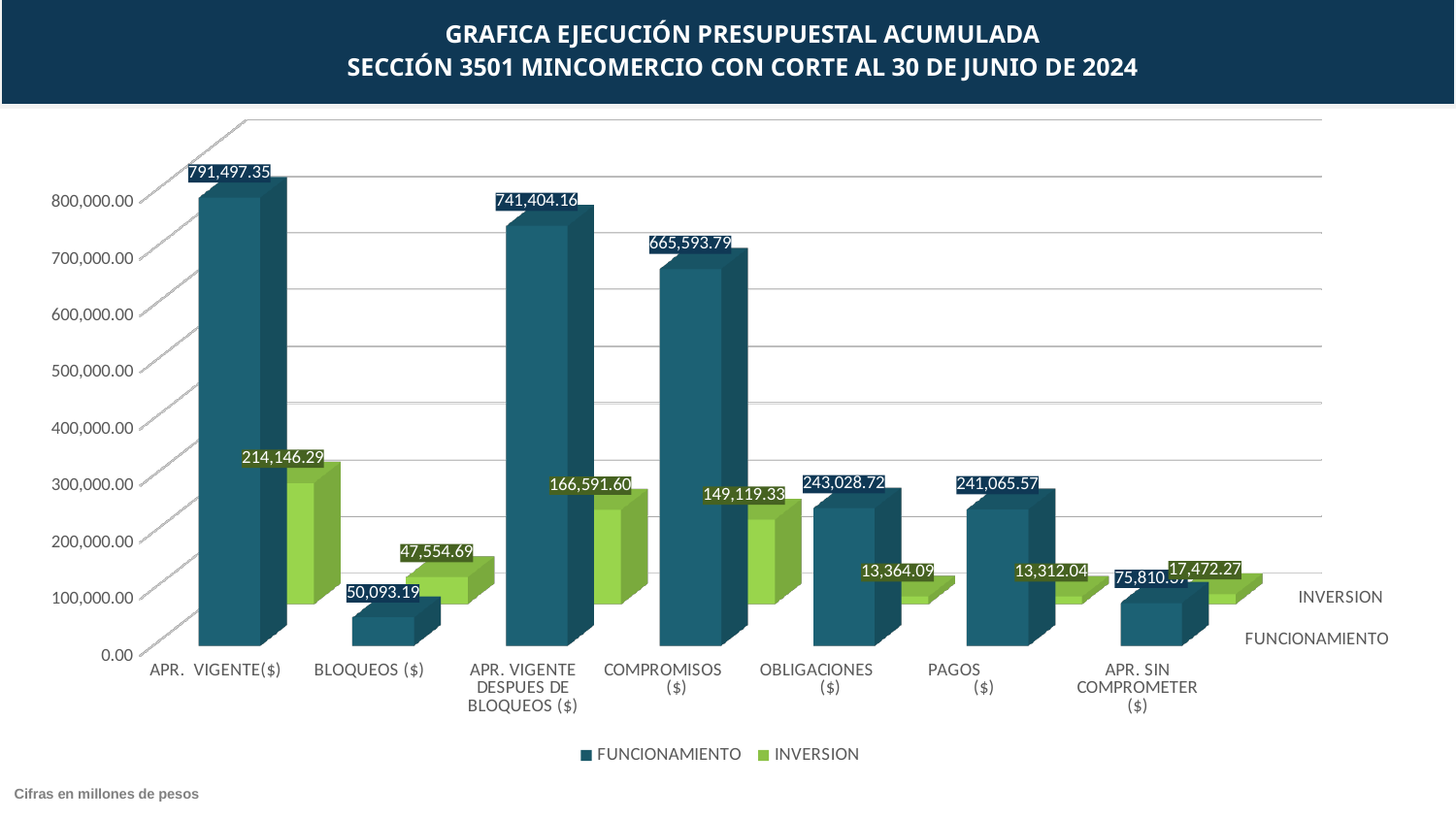
What is the difference between the FUNCIONAMIENTO values for APR. VIGENTE($) and APR. VIGENTE DESPUES DE BLOQUEOS ($)? 50,093.19 Which category has the highest FUNCIONAMIENTO value? APR. VIGENTE($) How many series does the legend list? 2 What is the FUNCIONAMIENTO value for APR. VIGENTE($)? 791,497.35 What is the INVERSION value for COMPROMISOS ($)? 149,119.33 What is the difference between the INVERSION values for APR. VIGENTE($) and BLOQUEOS ($)? 166,591.60 What kind of chart is shown on the slide? Bar chart Which is larger for FUNCIONAMIENTO: OBLIGACIONES ($) or PAGOS ($)? OBLIGACIONES ($) What is the FUNCIONAMIENTO value for BLOQUEOS ($)? 50,093.19 What is the INVERSION value for OBLIGACIONES ($)? 13,364.09 Which category has the lowest INVERSION value? PAGOS ($) How many categories are shown on the x axis? 7